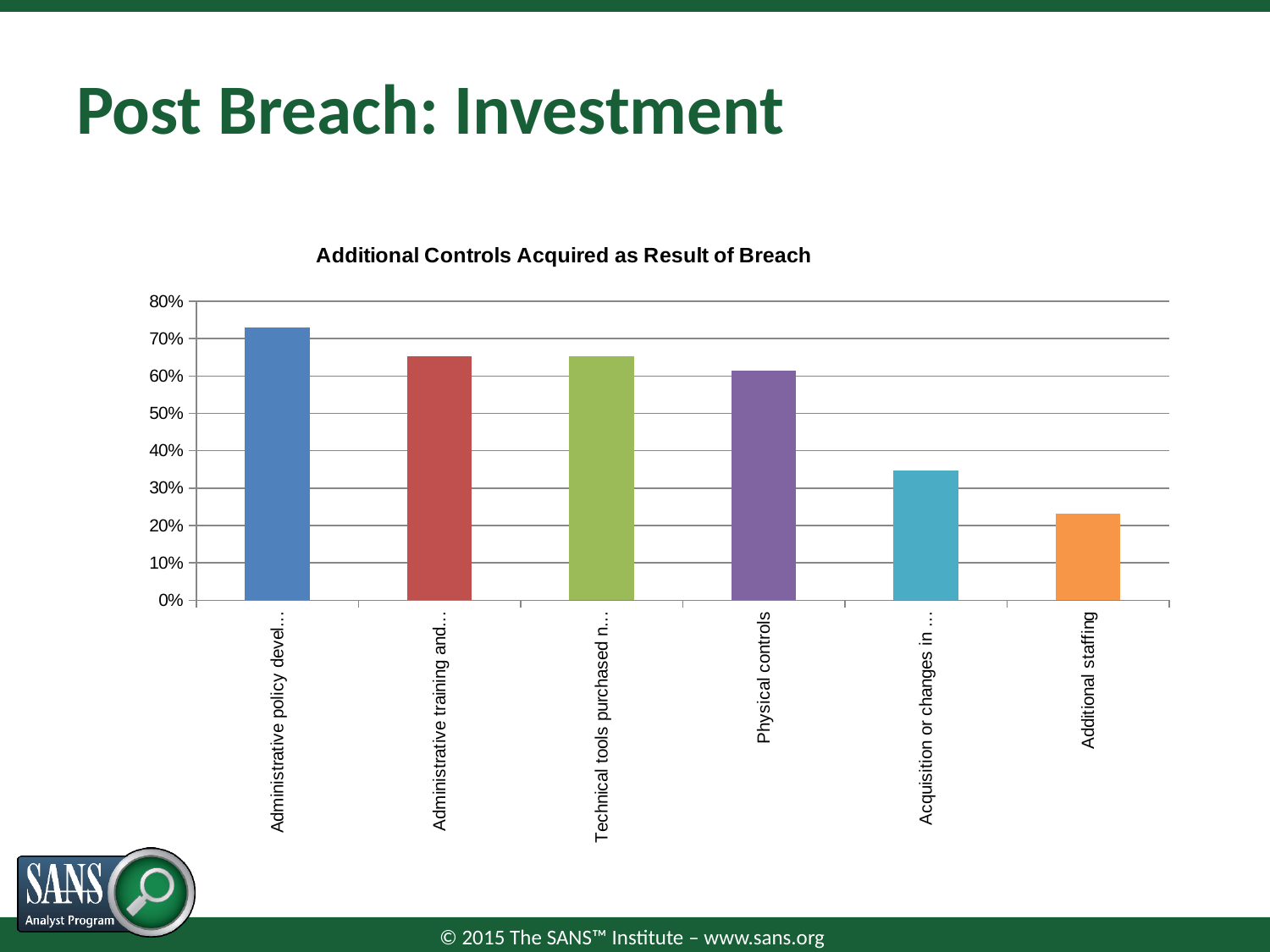
How many categories (bars) are plotted in the chart? 6 Which is larger, the value for Physical controls or the value for Additional staffing? Physical controls What is the highest value shown on the vertical axis of the chart? 80% Which bar is the tallest in the chart? The first bar (Administrative policy devel...) Do the bar values generally rise or fall from left to right across the chart? Fall Which category has the lowest value in the chart? Additional staffing Is the value for Physical controls greater or less than 50%? greater Is the value for Acquisition or changes in ... greater or less than 30%? greater Is the value for the first bar (Administrative policy devel...) greater or less than 70%? greater What is the title of the chart? Additional Controls Acquired as Result of Breach What kind of chart is shown on the slide? Bar chart